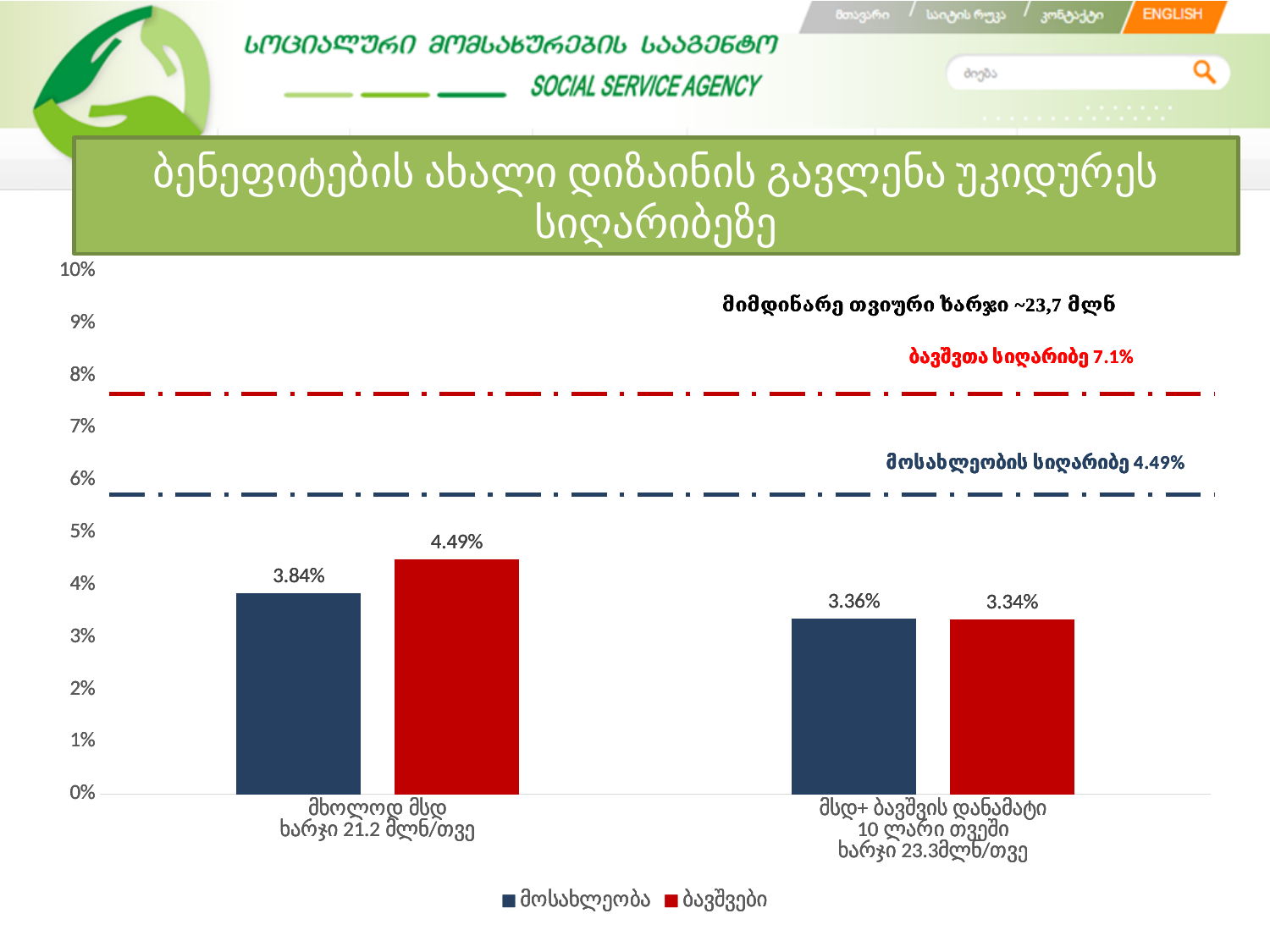
What type of chart is shown on the slide? bar chart How many series does the legend list? 2 Which bar has the highest value in the chart? ბავშვები in მხოლოდ მსდ (4.49%) What is the value for ბავშვები in the category მსდ+ ბავშვის დანამატი 10 ლარი თვეში? 3.34% What is the value for მოსახლეობა in the category მხოლოდ მსდ? 3.84% What is the value for ბავშვები in the category მხოლოდ მსდ? 4.49% What is the difference between the ბავშვები and მოსახლეობა values in the category მხოლოდ მსდ? 0.65% What value is given for ბავშვთა სიღარიბე on the red dashed reference line? 7.1% Which is larger in the category მხოლოდ მსდ: მოსახლეობა or ბავშვები? ბავშვები What is the value for მოსახლეობა in the category მსდ+ ბავშვის დანამატი 10 ლარი თვეში? 3.36% What colour represents the series ბავშვები in the legend? red How many categories are shown on the x axis? 2